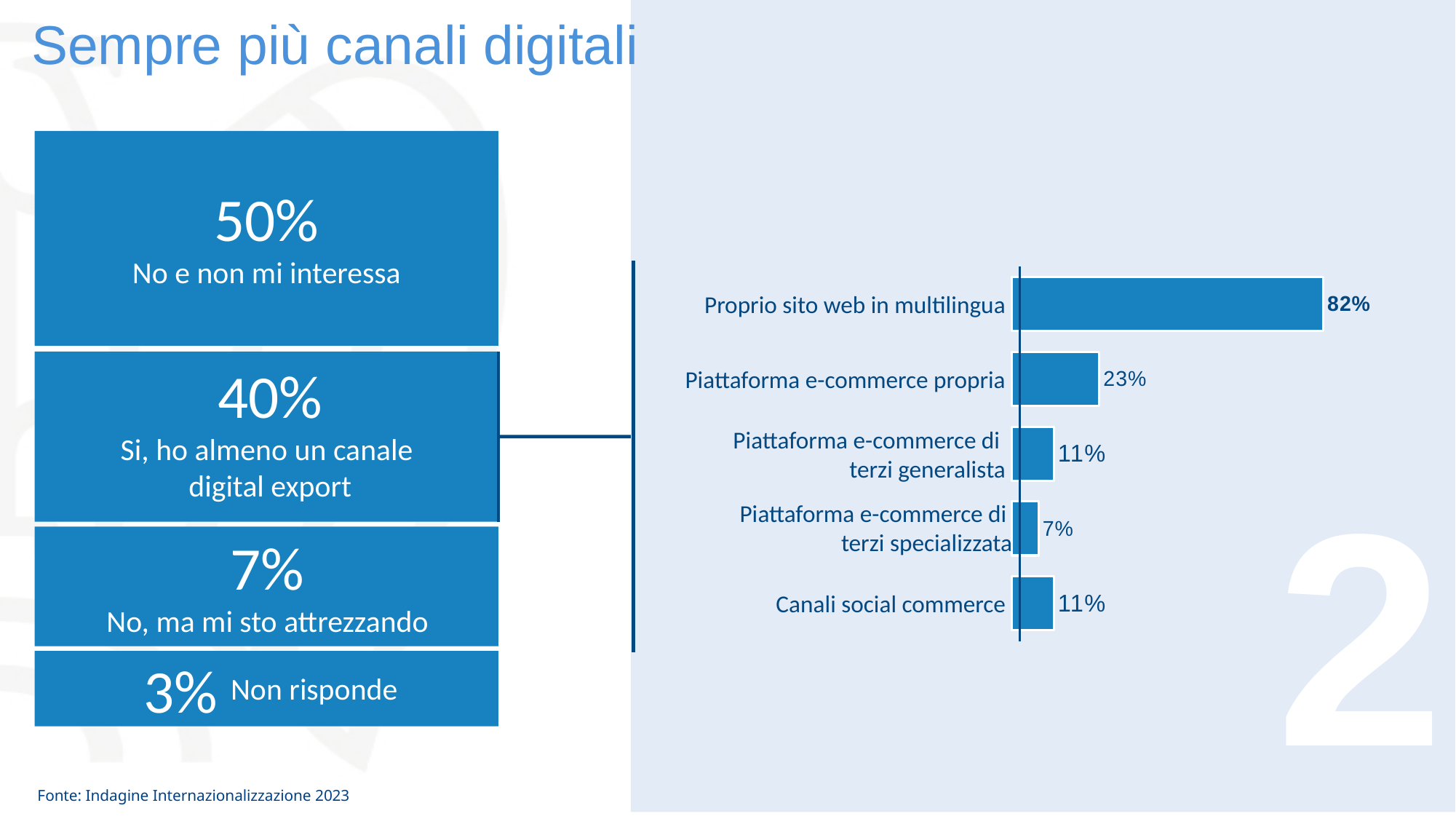
What is the difference between the values for 'Piattaforma e-commerce di terzi generalista' and 'Piattaforma e-commerce di terzi specializzata'? 4% Which category has the lowest value in the bar chart? Piattaforma e-commerce di terzi specializzata What is the value for 'Piattaforma e-commerce propria'? 23% How many categories are shown in the bar chart? 5 What is the value for 'Proprio sito web in multilingua'? 82% What is the title of the slide containing the bar chart? Sempre più canali digitali What is the value for 'Piattaforma e-commerce di terzi specializzata'? 7% What is the difference between the values for 'Proprio sito web in multilingua' and 'Piattaforma e-commerce propria'? 59% What type of chart is shown on the right side of the slide? bar chart Which is larger: the value for 'Piattaforma e-commerce propria' or 'Canali social commerce'? Piattaforma e-commerce propria Which category has the highest value in the bar chart? Proprio sito web in multilingua What is the value for 'Canali social commerce'? 11%